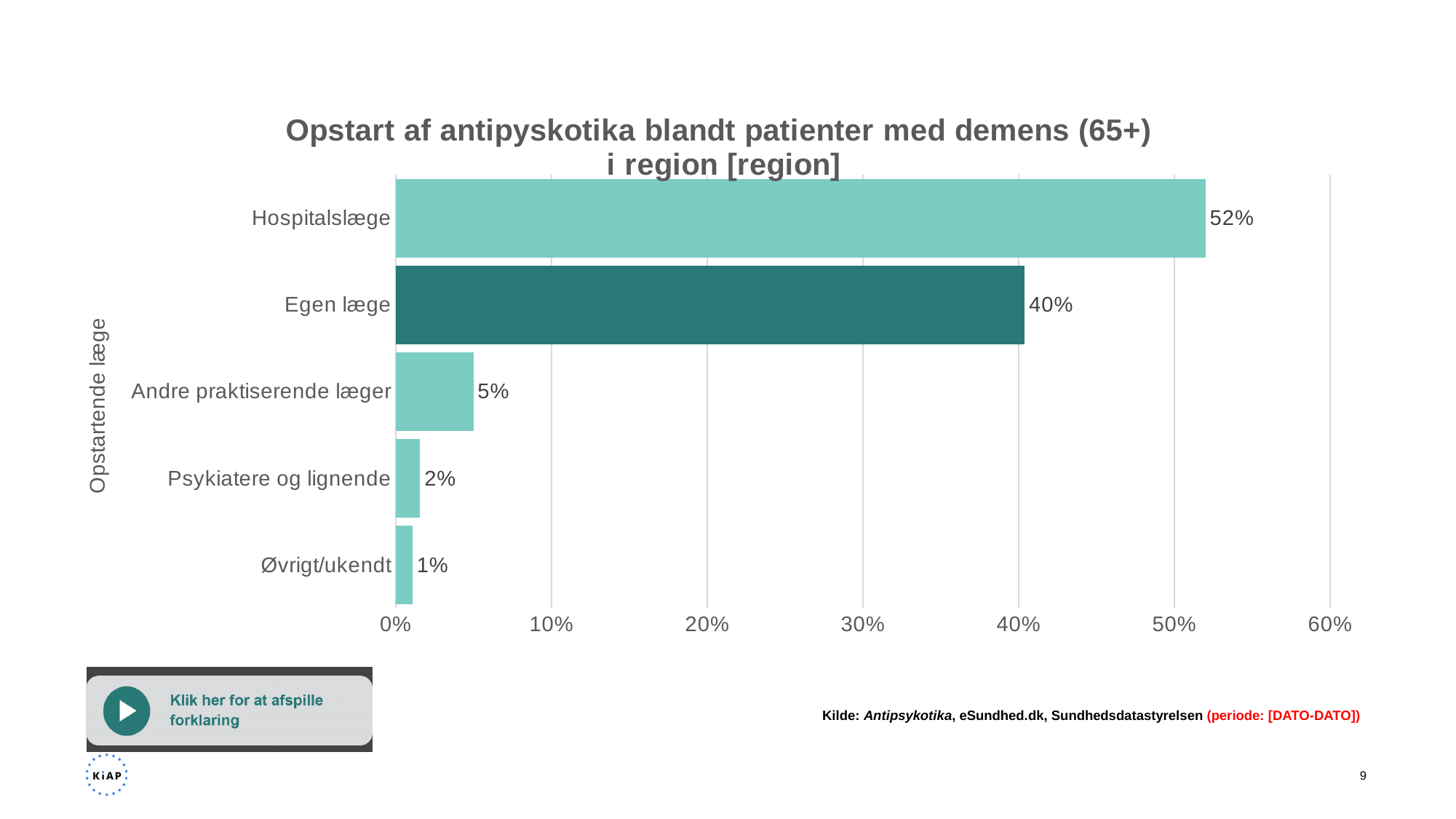
What kind of chart is shown on the slide? bar chart What is the value for Hospitalslæge? 52% How many categories are shown on the chart? 5 What is the value for Psykiatere og lignende? 2% Which category has the highest value? Hospitalslæge Which category has the lowest value? Øvrigt/ukendt What is the difference between the values for Hospitalslæge and Egen læge? 12% Which is larger, the value for Andre praktiserende læger or the value for Psykiatere og lignende? Andre praktiserende læger What is the value for Egen læge? 40% What is the label of the vertical axis? Opstartende læge What is the value for Andre praktiserende læger? 5% Is the value for Egen læge greater or less than 50%? less